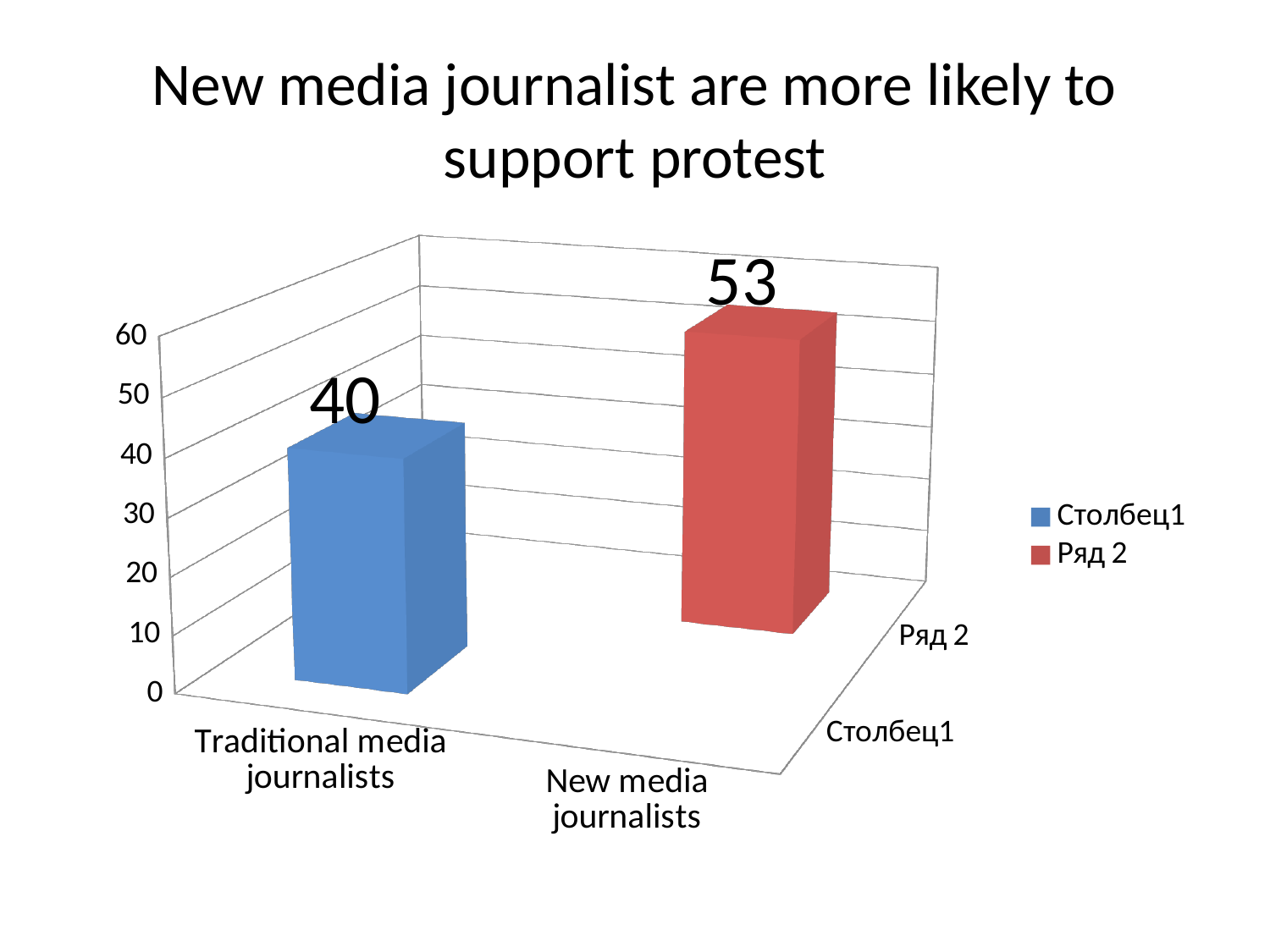
What is the title of the chart? New media journalist are more likely to support protest What is the difference between the values for New media journalists and Traditional media journalists? 13 Which is larger, the value for Traditional media journalists or the value for New media journalists? New media journalists What is the value for New media journalists? 53 Is the value for New media journalists greater or less than 50? greater How many categories are shown on the x axis? 2 Which category has the highest value? New media journalists What kind of chart is shown on the slide? bar chart What is the value for Traditional media journalists? 40 Is the value for Traditional media journalists greater or less than 50? less How many series does the legend list? 2 Which category has the lowest value? Traditional media journalists